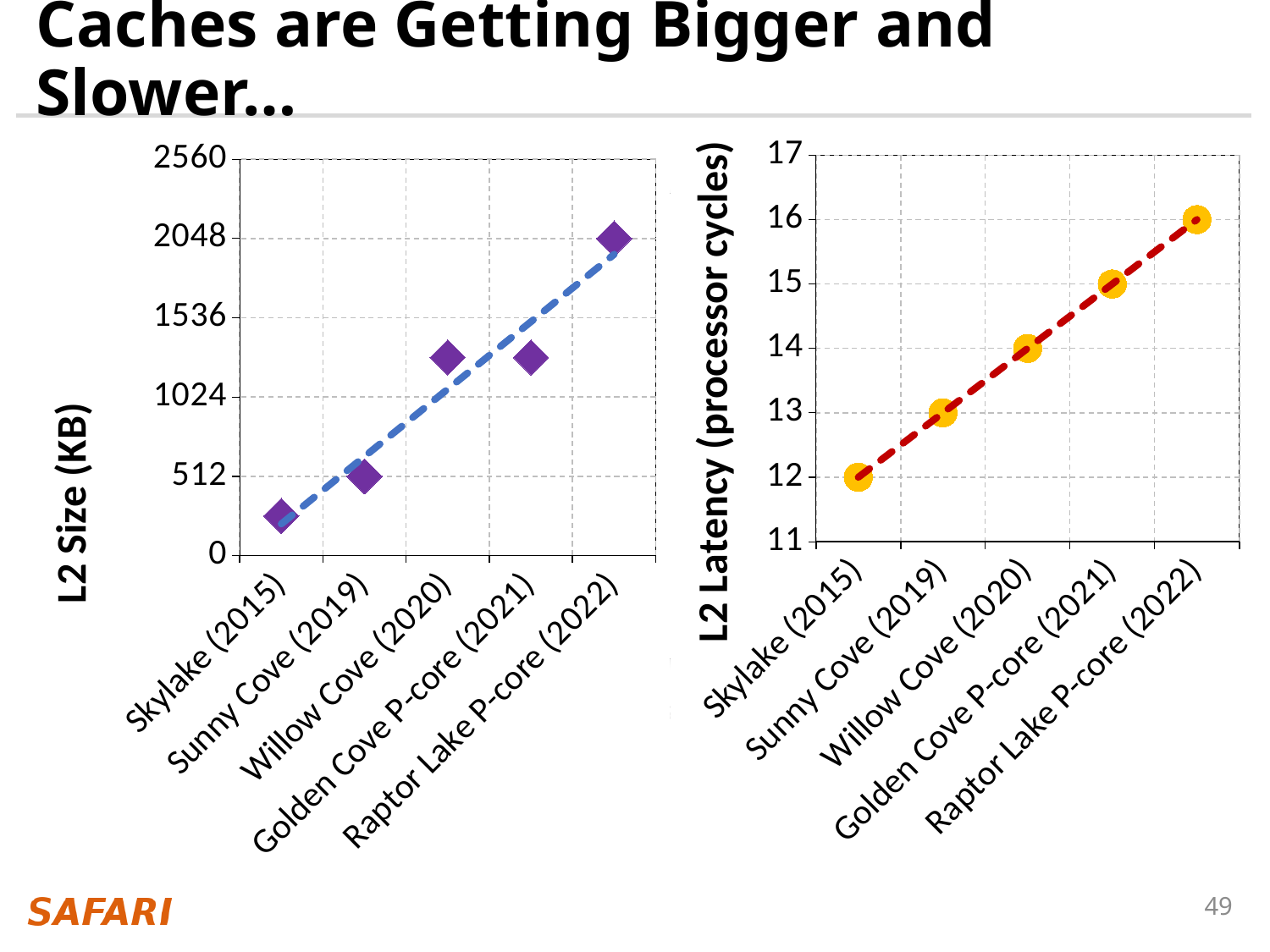
On the right chart (L2 Latency), what is the L2 latency for Skylake (2015)? 12 On the right chart (L2 Latency), do the values rise or fall from Skylake (2015) to Raptor Lake P-core (2022)? rise On the right chart (L2 Latency), what is the L2 latency for Willow Cove (2020)? 14 On the left chart (L2 Size), is the value for Skylake (2015) greater or less than 512? less On the right chart (L2 Latency), what is the L2 latency for Raptor Lake P-core (2022)? 16 On the right chart (L2 Latency), which processor has the highest L2 latency? Raptor Lake P-core (2022) On the left chart (L2 Size), what is the L2 size for Raptor Lake P-core (2022)? 2048 On the left chart (L2 Size), is the value for Willow Cove (2020) greater or less than 1024? greater On the left chart (L2 Size), which processor has the smallest L2 size? Skylake (2015) On the right chart (L2 Latency), how many processor cycles higher is the latency of Raptor Lake P-core (2022) than Skylake (2015)? 4 On the left chart (L2 Size), what is the L2 size for Sunny Cove (2019)? 512 How many processors are plotted on the right chart (L2 Latency)? 5